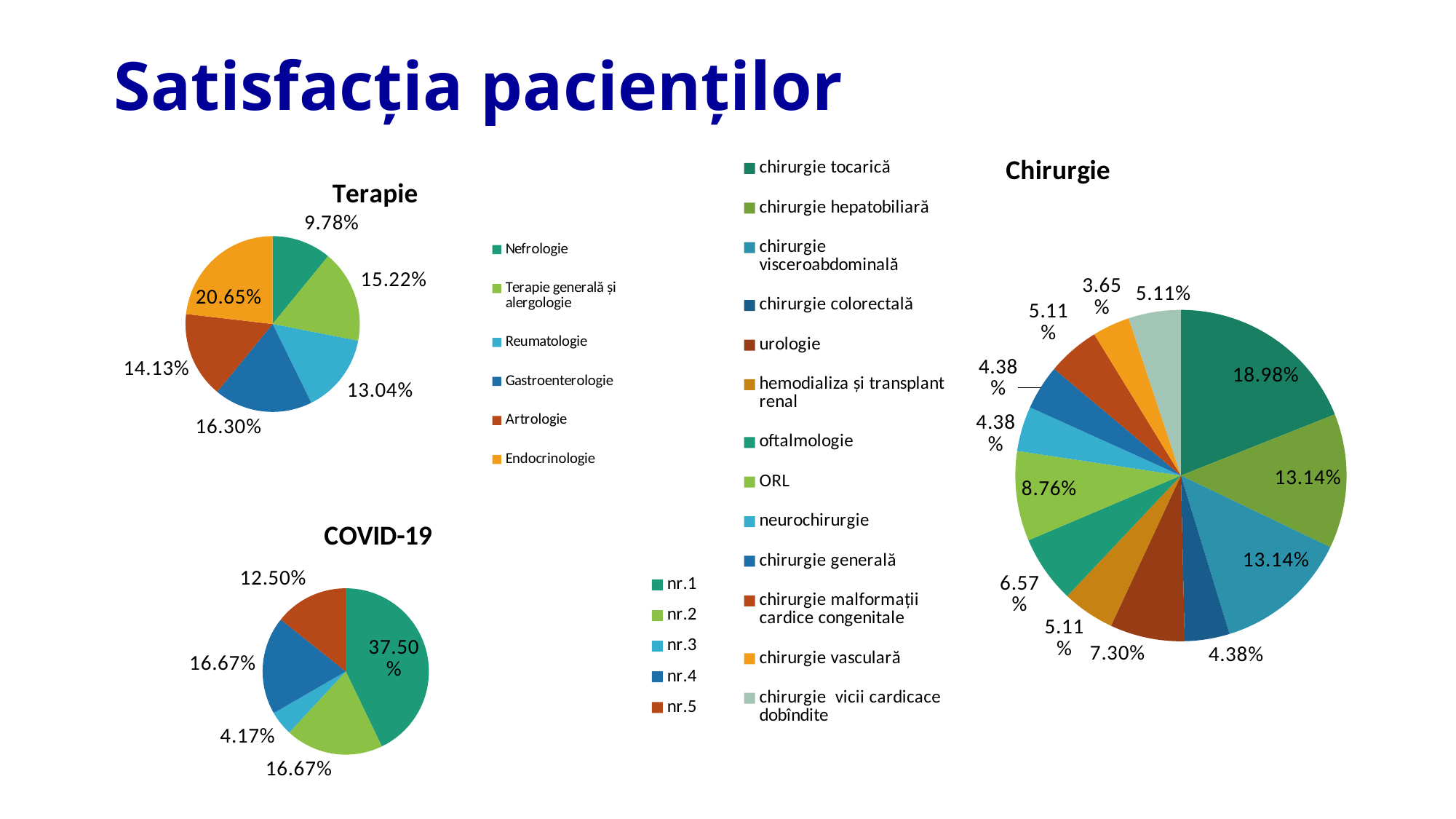
In the Terapie pie chart, what is the difference between the Gastroenterologie and Reumatologie shares? 3.26% In the Chirurgie pie chart, which category has the largest share? chirurgie tocarică In the Chirurgie pie chart, what share does chirurgie tocarică have? 18.98% How many categories does the Chirurgie pie chart show? 13 How many series does the legend of the COVID-19 chart list? 5 In the COVID-19 pie chart, which category has the smallest share? nr.3 In the Chirurgie pie chart, which is larger: ORL or oftalmologie? ORL In the Terapie pie chart, what share does Endocrinologie have? 20.65% In the Terapie pie chart, which category has the smallest share? Nefrologie What type of chart is the Chirurgie chart? Pie chart In the COVID-19 pie chart, what share does nr.1 have? 37.50% How many categories does the Terapie pie chart show? 6